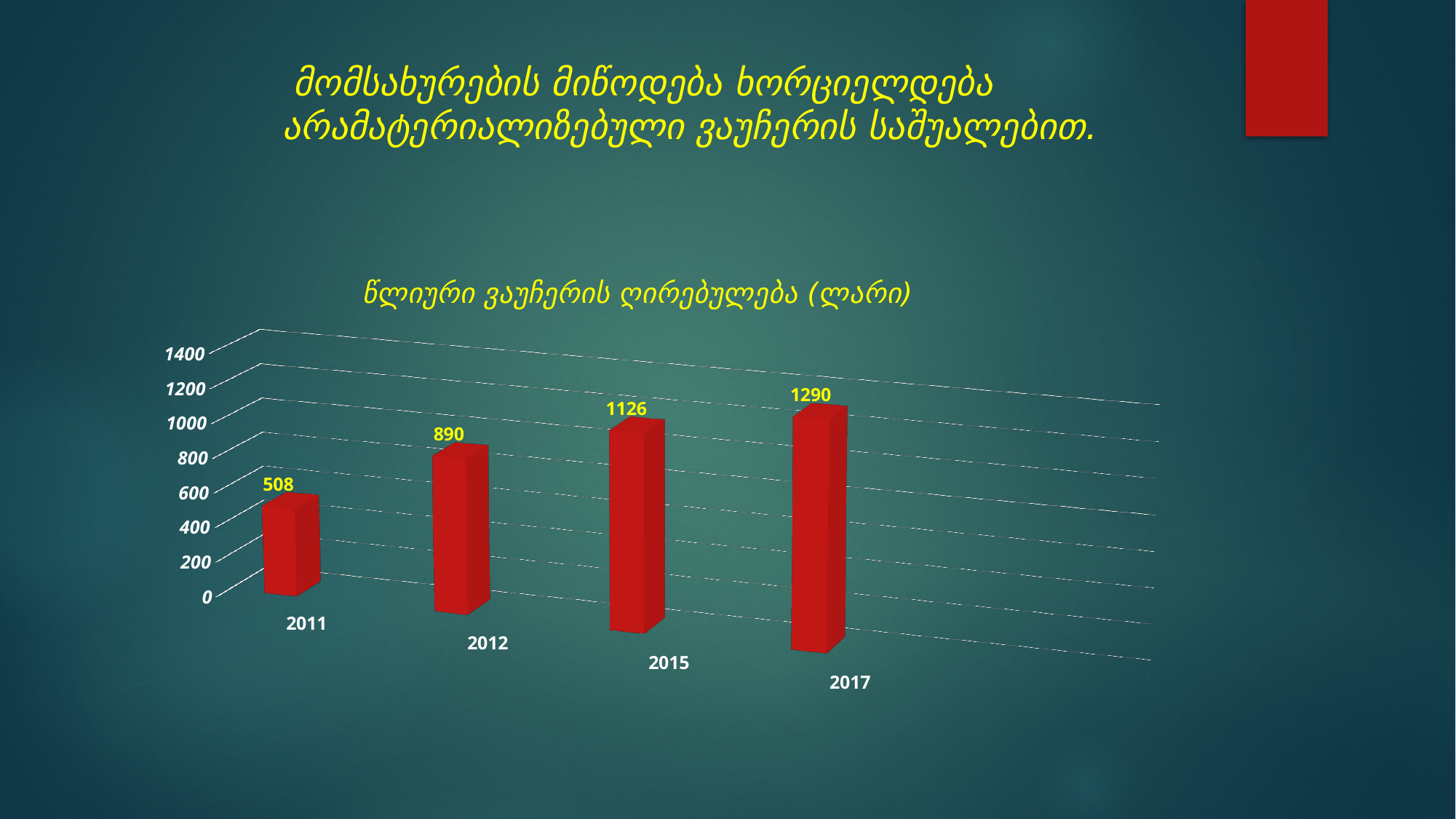
What is the value for 2015? 1126 How many years are shown on the chart? 4 What is the difference between the values for 2015 and 2012? 236 What is the value for 2017? 1290 Which is larger, the value for 2012 or the value for 2015? 2015 What is the value for 2012? 890 What is the value for 2011? 508 What kind of chart is shown on the slide? bar chart Which year has the lowest value? 2011 What is the difference between the values for 2017 and 2011? 782 Which year has the highest value? 2017 Do the values rise or fall from 2011 to 2017? rise